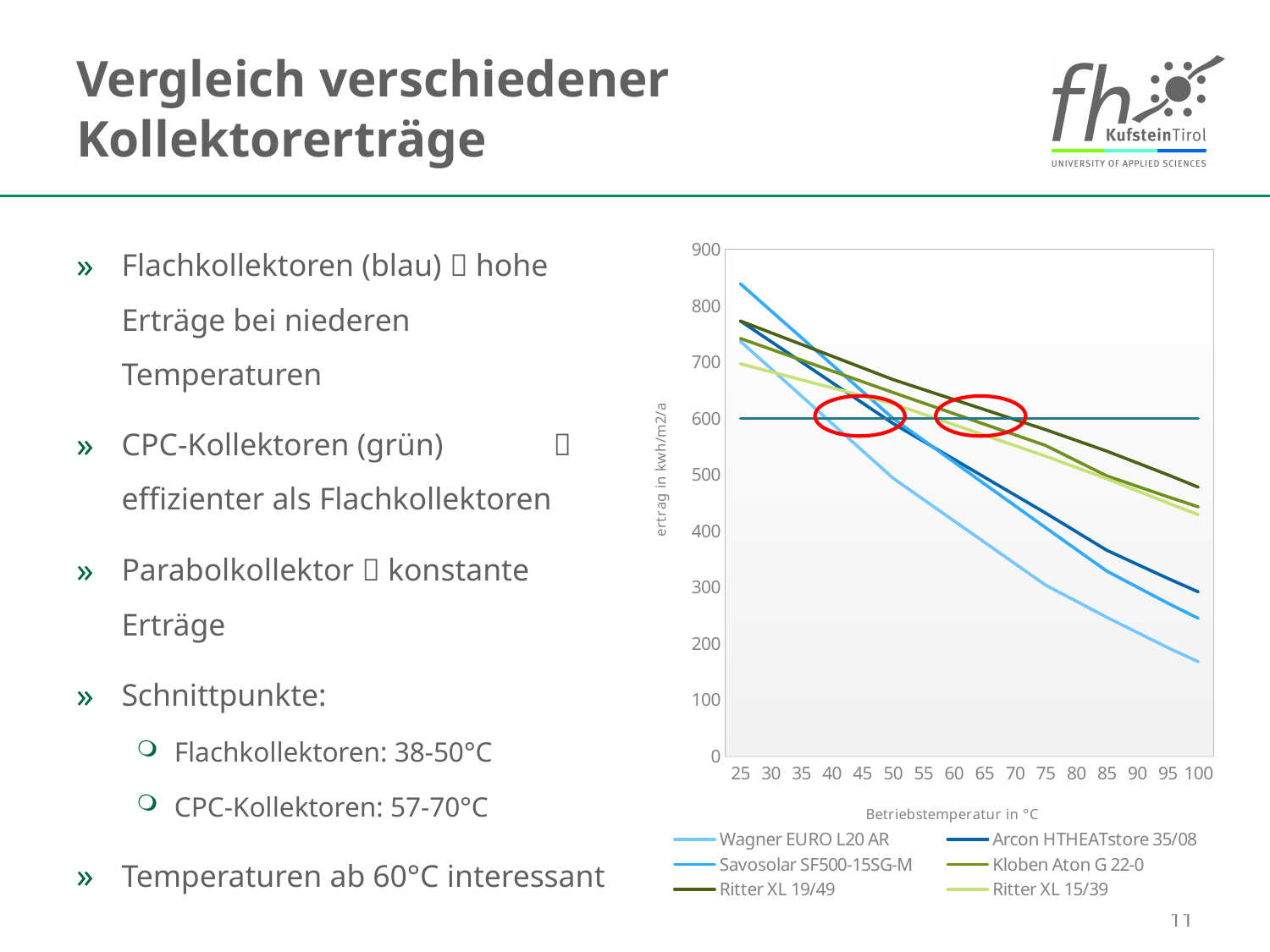
Is the value for Kloben Aton G 22-0 at 25 °C greater or less than 700? greater Which series has the lowest value at 100 °C? Wagner EURO L20 AR What is the label of the x axis of the chart? Betriebstemperatur in °C Is the value for Ritter XL 19/49 at 100 °C greater or less than 500? less Is the value for Wagner EURO L20 AR at 100 °C greater or less than 200? less Do the values of the Wagner EURO L20 AR series rise or fall as the Betriebstemperatur increases? fall Which series has the highest value at 25 °C? Savosolar SF500-15SG-M What kind of chart is shown on the slide? line chart How many series does the chart legend list? 6 At 100 °C, which is larger: the value for Ritter XL 19/49 or the value for Wagner EURO L20 AR? Ritter XL 19/49 What is the label of the y axis of the chart? ertrag in kwh/m2/a